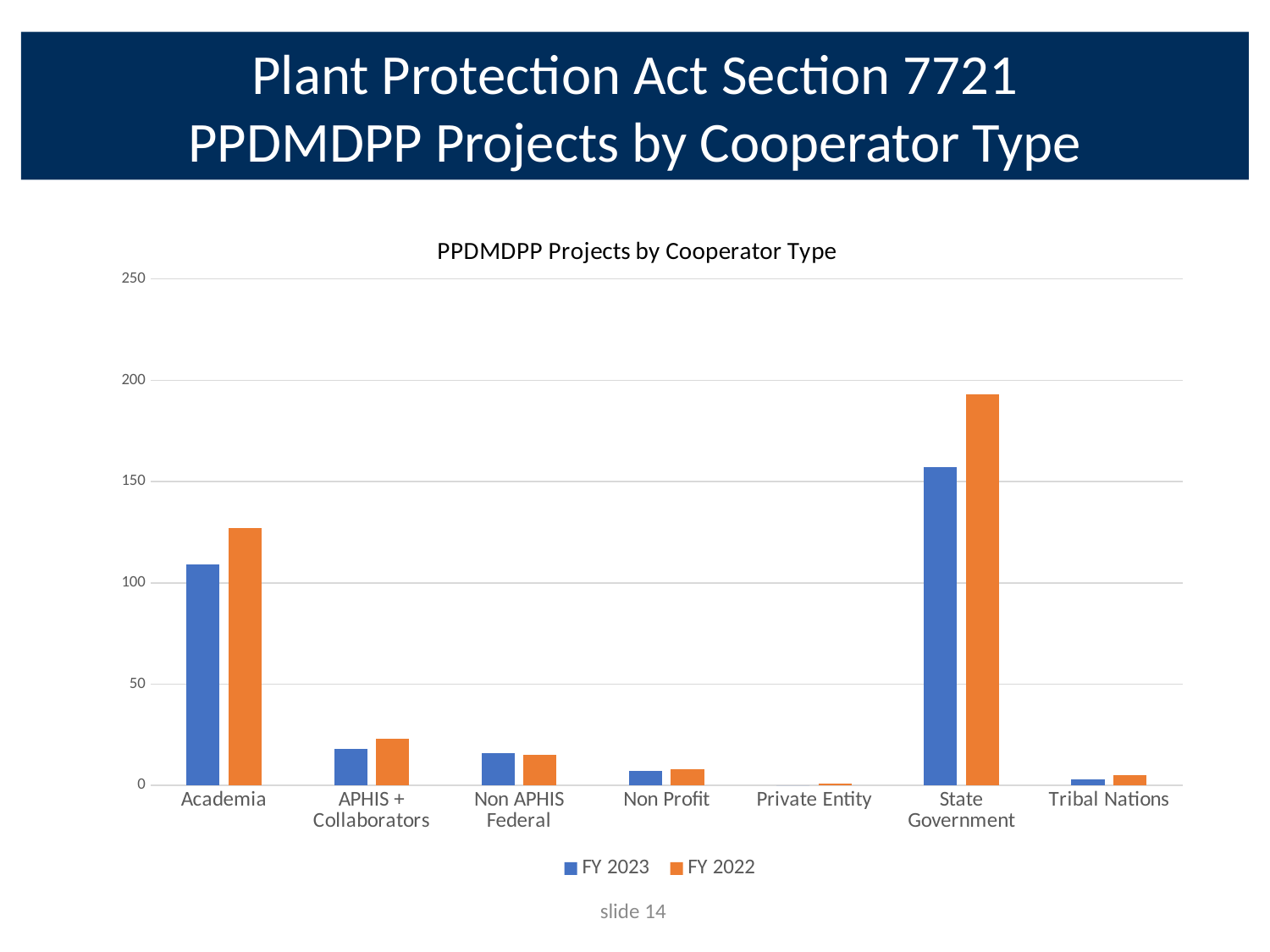
How many cooperator type categories are shown on the x axis? 7 For Academia, which is larger: the FY 2023 value or the FY 2022 value? FY 2022 What kind of chart is shown on the slide? Bar chart Is the FY 2022 value for APHIS + Collaborators greater or less than 50? less Which cooperator type has the highest number of projects in FY 2022? State Government Which series is shown in orange in the legend? FY 2022 Is the FY 2022 value for State Government greater or less than 200? less Is the FY 2023 value for State Government greater or less than 150? greater How many series does the legend list? 2 Which cooperator type has the lowest number of projects in FY 2022? Private Entity Which cooperator type has the highest number of projects in FY 2023? State Government